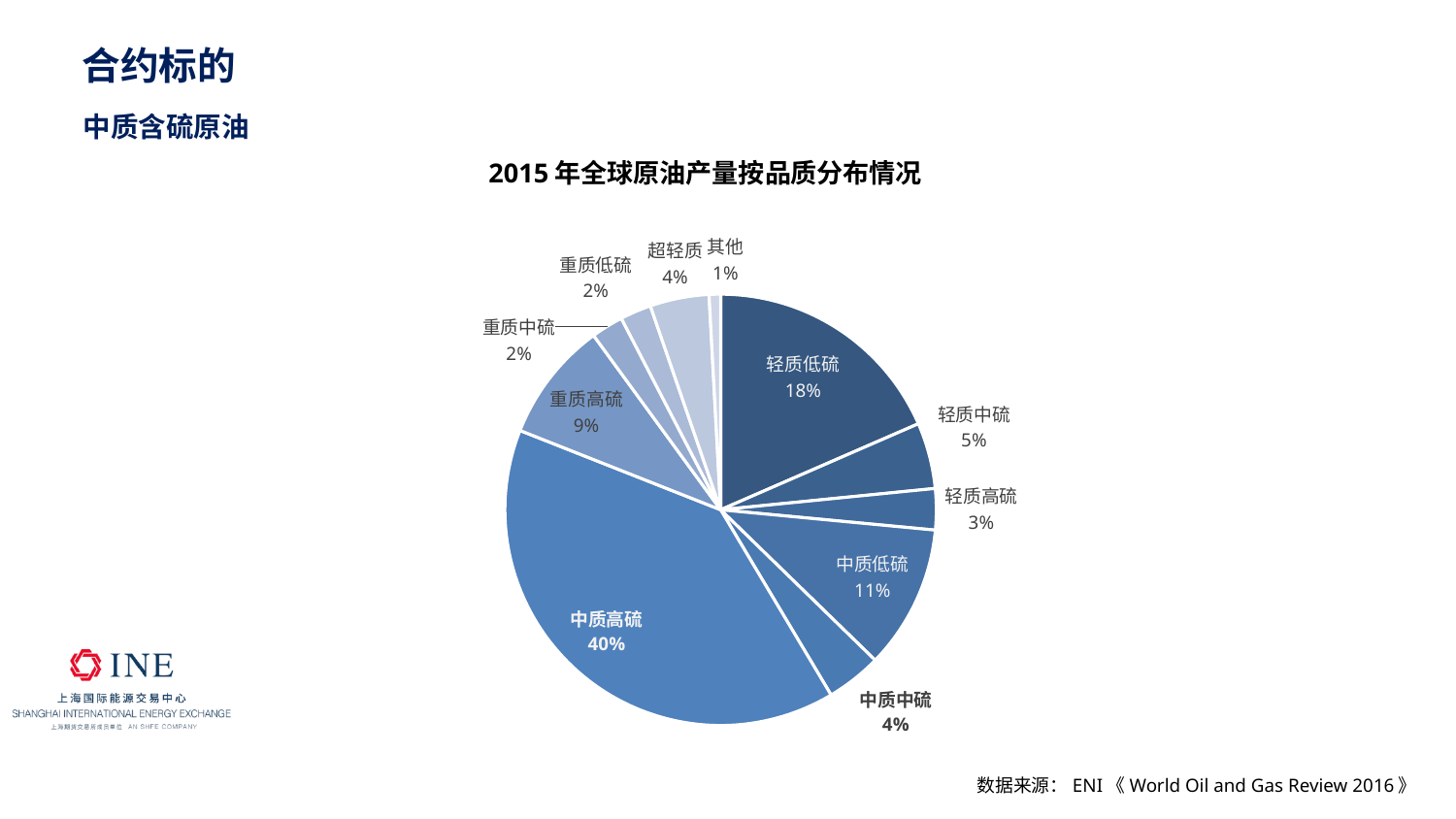
Which category has the largest slice of the pie? 中质高硫 What is the title of the chart? 2015 年全球原油产量按品质分布情况 Which category has the smallest slice of the pie? 其他 Which is larger, the share of 轻质中硫 or the share of 轻质高硫? 轻质中硫 What is the value shown for 中质低硫? 11% What is the combined share of 中质低硫 and 中质中硫? 15% What share of the pie does 中质高硫 account for? 40% What is the difference between the shares of 中质高硫 and 轻质低硫? 22% How many slices does the pie chart have? 11 What is the value shown for 轻质低硫? 18% What is the value shown for 重质高硫? 9% What type of chart is shown on the slide? pie chart